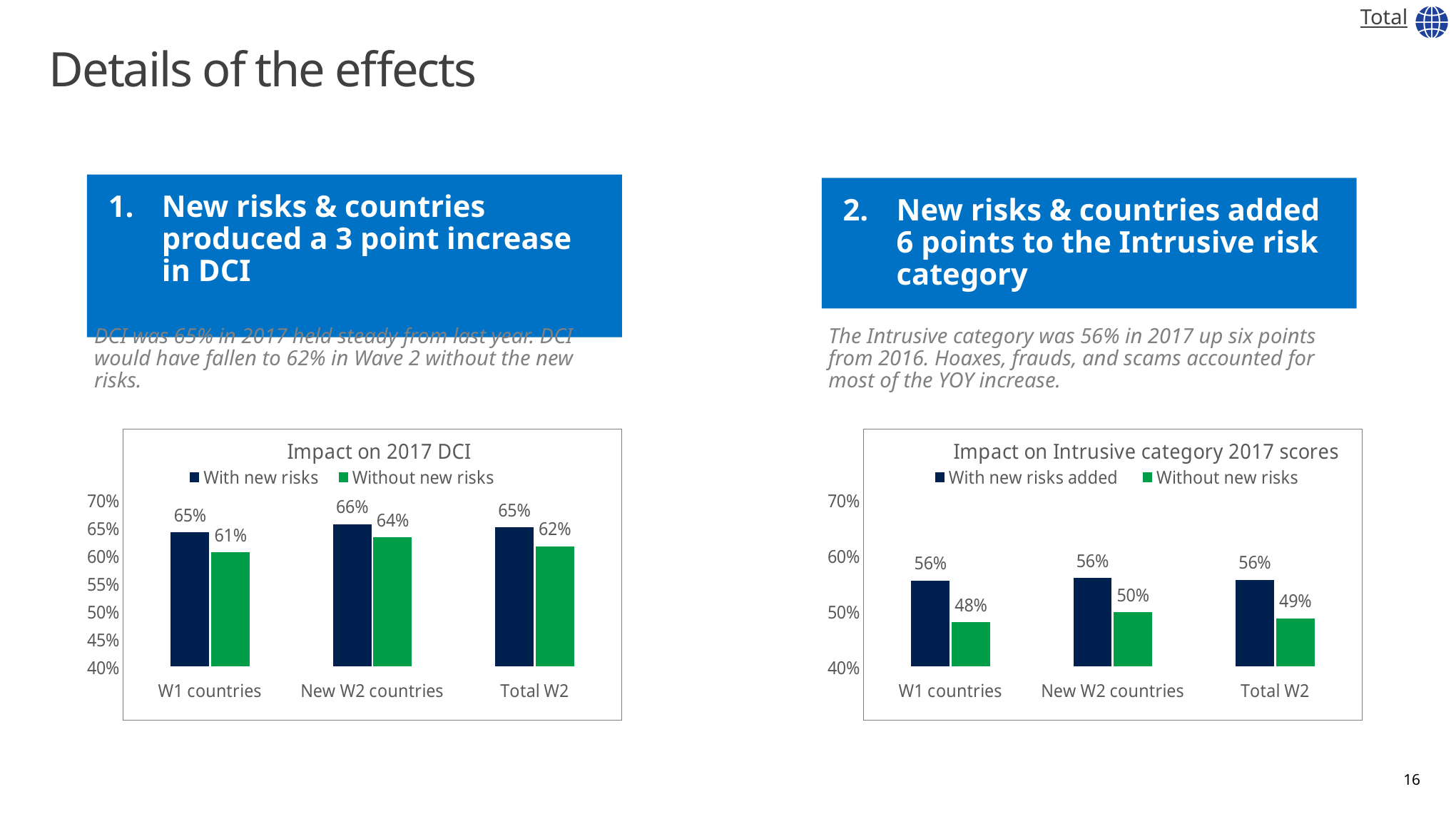
In the 'Impact on Intrusive category 2017 scores' chart, which category has the highest 'Without new risks' value? New W2 countries In the 'Impact on 2017 DCI' chart, which category has the lowest 'Without new risks' value? W1 countries What kind of chart is the 'Impact on Intrusive category 2017 scores' chart? Bar chart In the 'Impact on Intrusive category 2017 scores' chart, what is the value for 'With new risks added' for New W2 countries? 56% In the 'Impact on Intrusive category 2017 scores' chart, what is the difference between 'With new risks added' and 'Without new risks' for W1 countries? 8% How many series does the legend of the 'Impact on 2017 DCI' chart list? 2 In the 'Impact on Intrusive category 2017 scores' chart, what is the value for 'Without new risks' for Total W2? 49% In the 'Impact on 2017 DCI' chart, what is the value for 'Without new risks' for New W2 countries? 64% In the 'Impact on 2017 DCI' chart, what is the difference between 'With new risks' and 'Without new risks' for Total W2? 3% In the 'Impact on Intrusive category 2017 scores' chart, is the 'Without new risks' value for W1 countries greater or less than 50%? less In the 'Impact on 2017 DCI' chart, what is the value for 'With new risks' for W1 countries? 65% In the 'Impact on 2017 DCI' chart, which category has the highest 'With new risks' value? New W2 countries